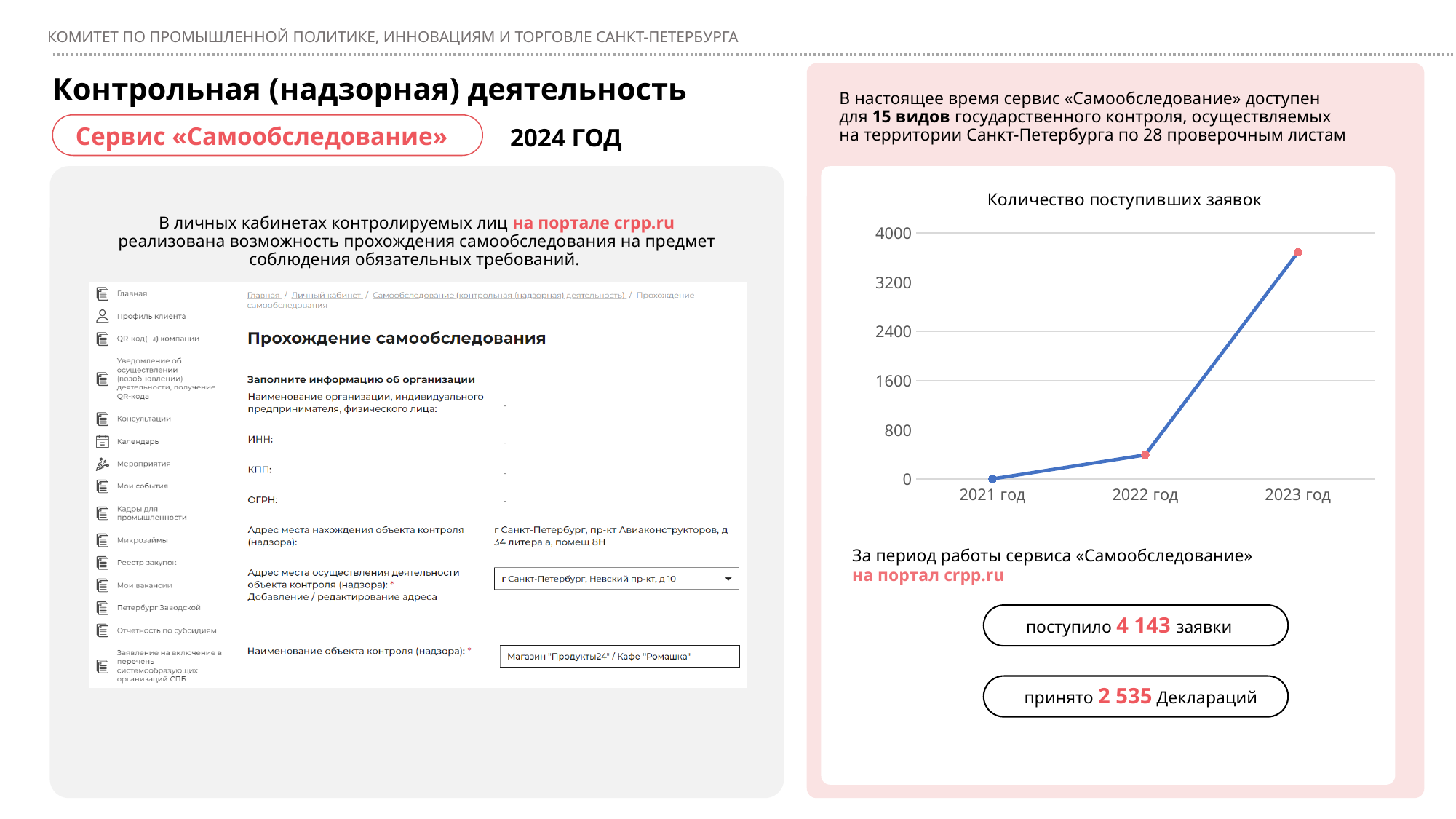
Is the value for 2023 год in the chart «Количество поступивших заявок» greater or less than 3200? greater Do the values in the chart «Количество поступивших заявок» rise or fall from 2021 год to 2023 год? rise Is the value for 2022 год in the chart «Количество поступивших заявок» greater or less than 800? less Which year has the lowest value in the chart «Количество поступивших заявок»? 2021 год What is the highest tick value shown on the y axis of the chart «Количество поступивших заявок»? 4000 Which year has the highest value in the chart «Количество поступивших заявок»? 2023 год Is the value for 2023 год in the chart «Количество поступивших заявок» greater or less than 4000? less How many years are plotted on the x axis of the chart «Количество поступивших заявок»? 3 In the chart «Количество поступивших заявок», which is larger: the value for 2022 год or for 2023 год? 2023 год What kind of chart is shown under the title «Количество поступивших заявок»? line chart What is the title of the chart on the right side of the slide? Количество поступивших заявок